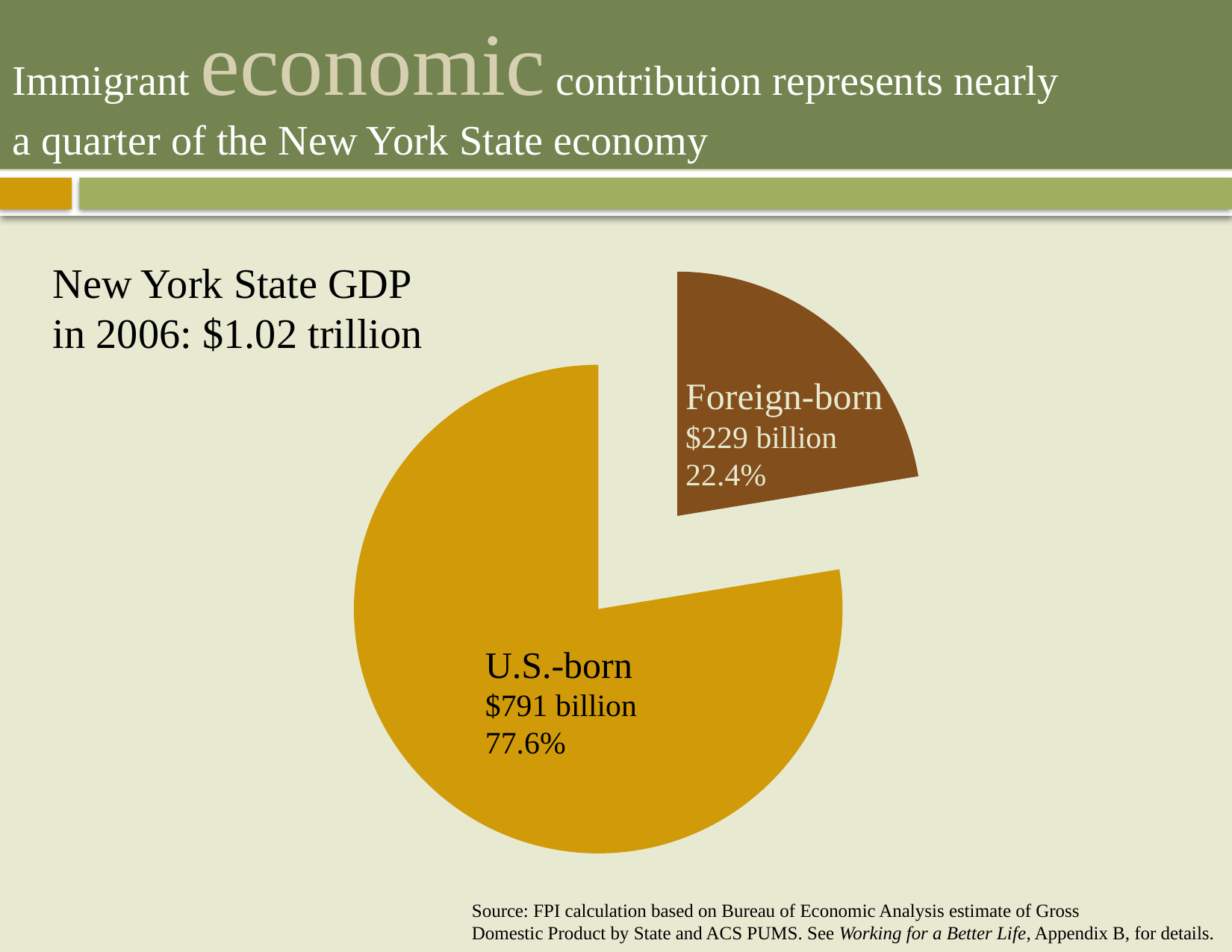
Which is larger, the U.S.-born slice or the Foreign-born slice? U.S.-born What is the dollar value shown for the U.S.-born slice? $791 billion What is the dollar value shown for the Foreign-born slice? $229 billion Which slice of the pie is the largest? U.S.-born What is the difference in billions of dollars between the U.S.-born and Foreign-born slices? $562 billion What share of the pie does the Foreign-born slice represent? 22.4% Which slice of the pie is the smallest? Foreign-born How many slices does the pie chart have? 2 What total New York State GDP for 2006 is stated next to the chart? $1.02 trillion What colour is the Foreign-born slice? brown What share of the pie does the U.S.-born slice represent? 77.6% What kind of chart is shown on the slide? pie chart